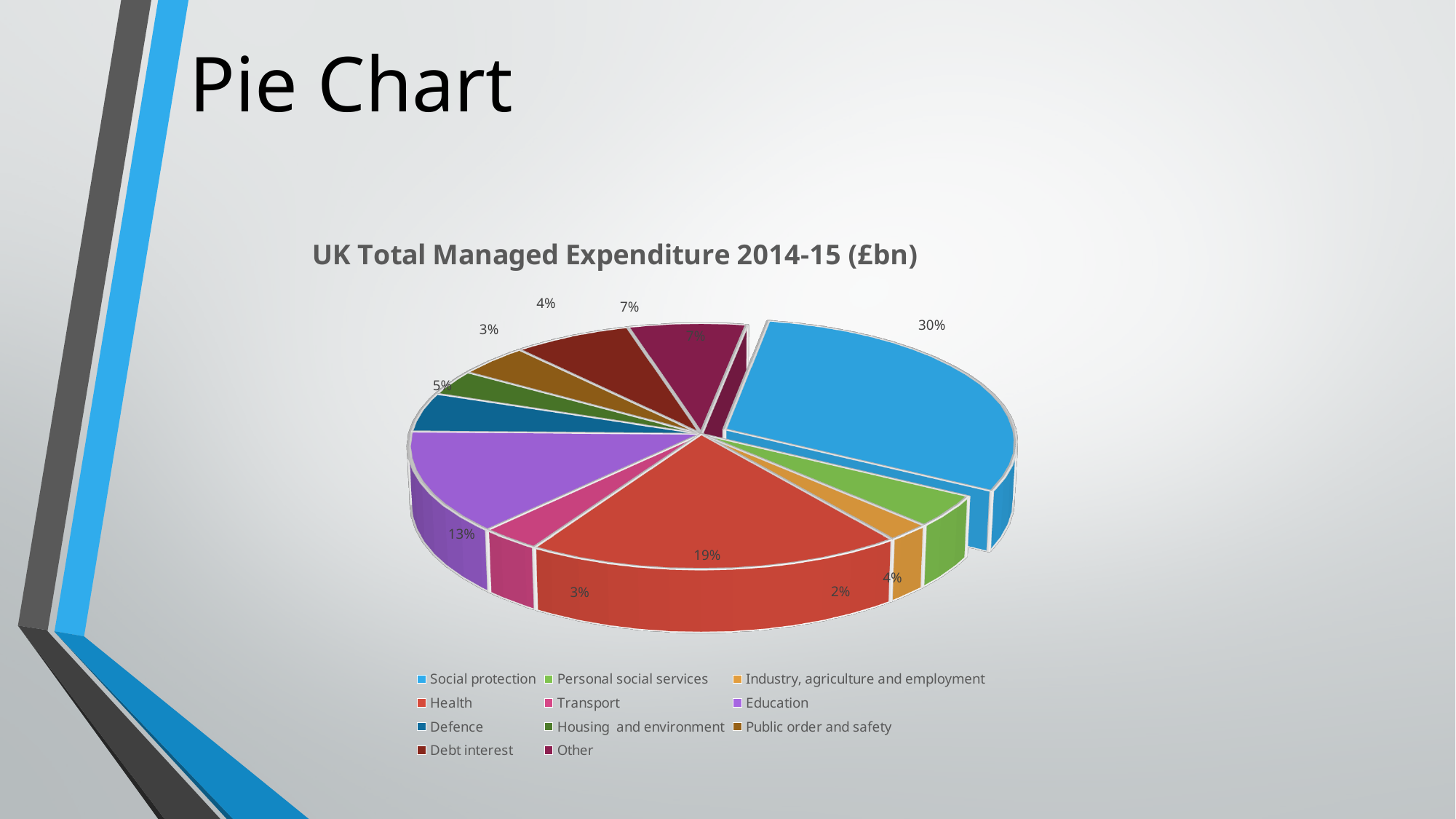
Which category has the smallest slice of the pie? Industry, agriculture and employment What is the value shown for Defence? 5% Which category has the largest slice of the pie? Social protection What percentage is shown for Debt interest? 7% How many categories are shown in the pie chart? 11 What percentage of the pie is Health? 19% Which is larger, the Education slice or the Defence slice? Education What is the title of the chart? UK Total Managed Expenditure 2014-15 (£bn) What share does Education take in the pie chart? 13% What share of UK Total Managed Expenditure 2014-15 is Social protection? 30% What type of chart is shown on the slide? Pie chart By how many percentage points does Social protection exceed Health? 11 percentage points